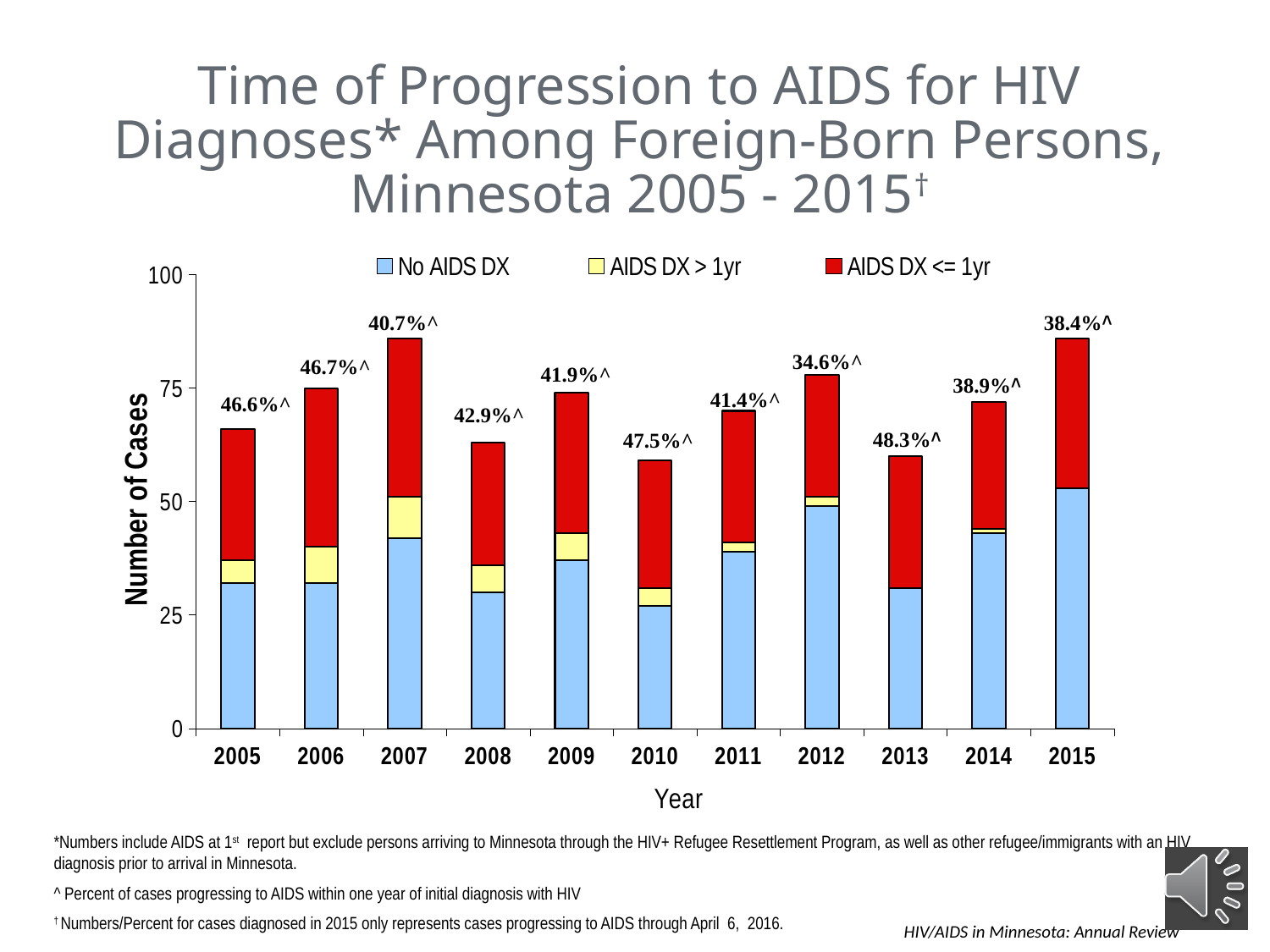
What is the difference between the percentage labels for 2013 and 2012? 13.7 percentage points Which year has the highest percentage label above its bar? 2013 How many years are shown on the x axis? 11 How many series does the legend list? 3 What kind of chart is shown on the slide? Stacked bar chart Is the total number of cases for 2008 greater or less than 75? less Is the total number of cases for 2007 greater or less than 75? greater What percentage label is shown above the 2013 bar? 48.3%^ What percentage label is shown above the 2007 bar? 40.7%^ What percentage label is shown above the 2015 bar? 38.4%^ Which year has the lowest percentage label above its bar? 2012 Which year has the larger percentage label, 2010 or 2014? 2010